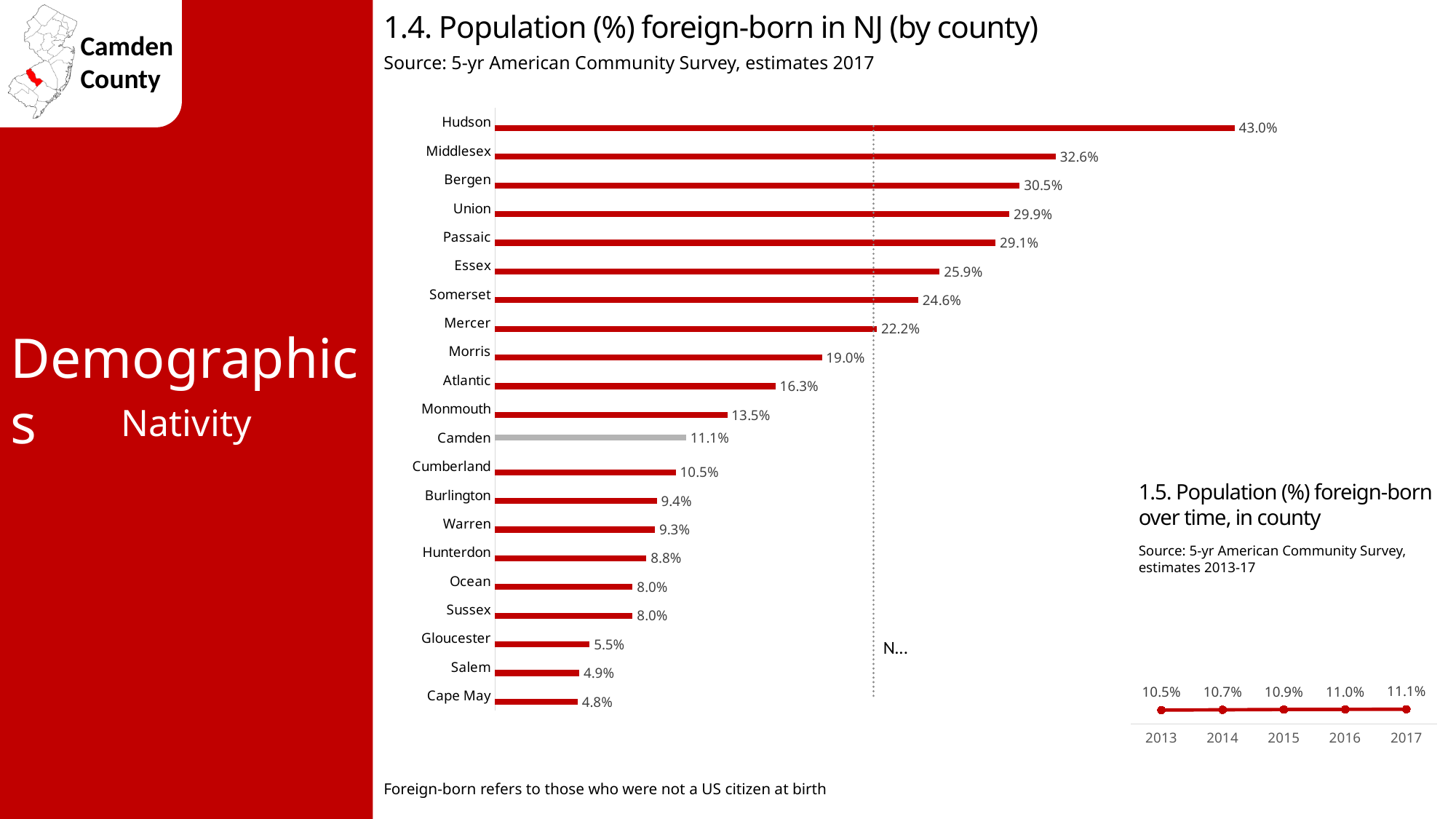
In the chart '1.4. Population (%) foreign-born in NJ (by county)', which county has the highest value? Hudson In the chart '1.4. Population (%) foreign-born in NJ (by county)', which is larger, Morris or Atlantic? Morris In the chart '1.4. Population (%) foreign-born in NJ (by county)', how many counties are shown? 21 In the chart '1.4. Population (%) foreign-born in NJ (by county)', what is the value for Camden? 11.1% In the chart '1.5. Population (%) foreign-born over time, in county', what is the difference between the 2017 and 2013 values? 0.6% In the chart '1.4. Population (%) foreign-born in NJ (by county)', which bar is coloured grey instead of red? Camden In the chart '1.4. Population (%) foreign-born in NJ (by county)', what is the value for Hudson? 43.0% In the chart '1.4. Population (%) foreign-born in NJ (by county)', which county has the lowest value? Cape May In the chart '1.5. Population (%) foreign-born over time, in county', what is the value for 2015? 10.9% In the chart '1.5. Population (%) foreign-born over time, in county', do the values rise or fall from 2013 to 2017? Rise What kind of chart is '1.4. Population (%) foreign-born in NJ (by county)'? Bar chart In the chart '1.4. Population (%) foreign-born in NJ (by county)', what is the difference between Middlesex and Bergen? 2.1%